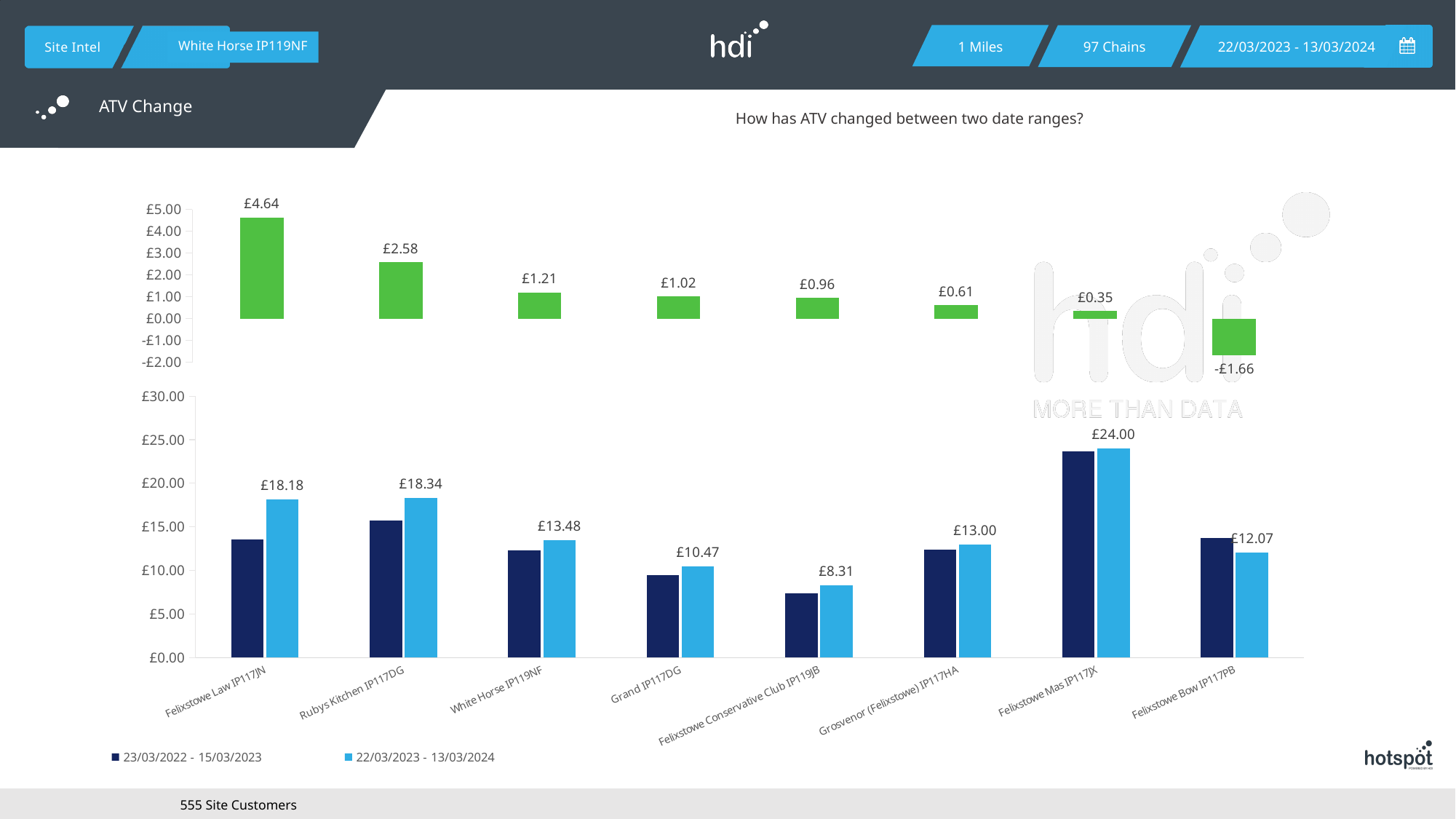
How many categories are shown on the x axis of the bottom chart? 8 In the bottom chart, which is larger for Felixstowe Bow IP117PB: the 23/03/2022 - 15/03/2023 value or the 22/03/2023 - 13/03/2024 value? 23/03/2022 - 15/03/2023 In the top chart, what is the difference between the values for Felixstowe Law IP117JN and Rubys Kitchen IP117DG? £2.06 In the bottom chart, is the 23/03/2022 - 15/03/2023 value for Felixstowe Mas IP117JX greater or less than £20.00? greater In the bottom chart, what is the value for Felixstowe Conservative Club IP119JB in the 22/03/2023 - 13/03/2024 series? £8.31 In the top chart, which category has the highest value? Felixstowe Law IP117JN In the top chart, which category has the lowest value? Felixstowe Bow IP117PB In the top chart, what is the value shown for Felixstowe Bow IP117PB? -£1.66 How many series does the legend of the bottom chart list? 2 In the bottom chart, which category has the highest value in the 22/03/2023 - 13/03/2024 series? Felixstowe Mas IP117JX In the bottom chart, what is the value for Felixstowe Mas IP117JX in the 22/03/2023 - 13/03/2024 series? £24.00 In the top chart, what is the ATV change value for Felixstowe Law IP117JN? £4.64